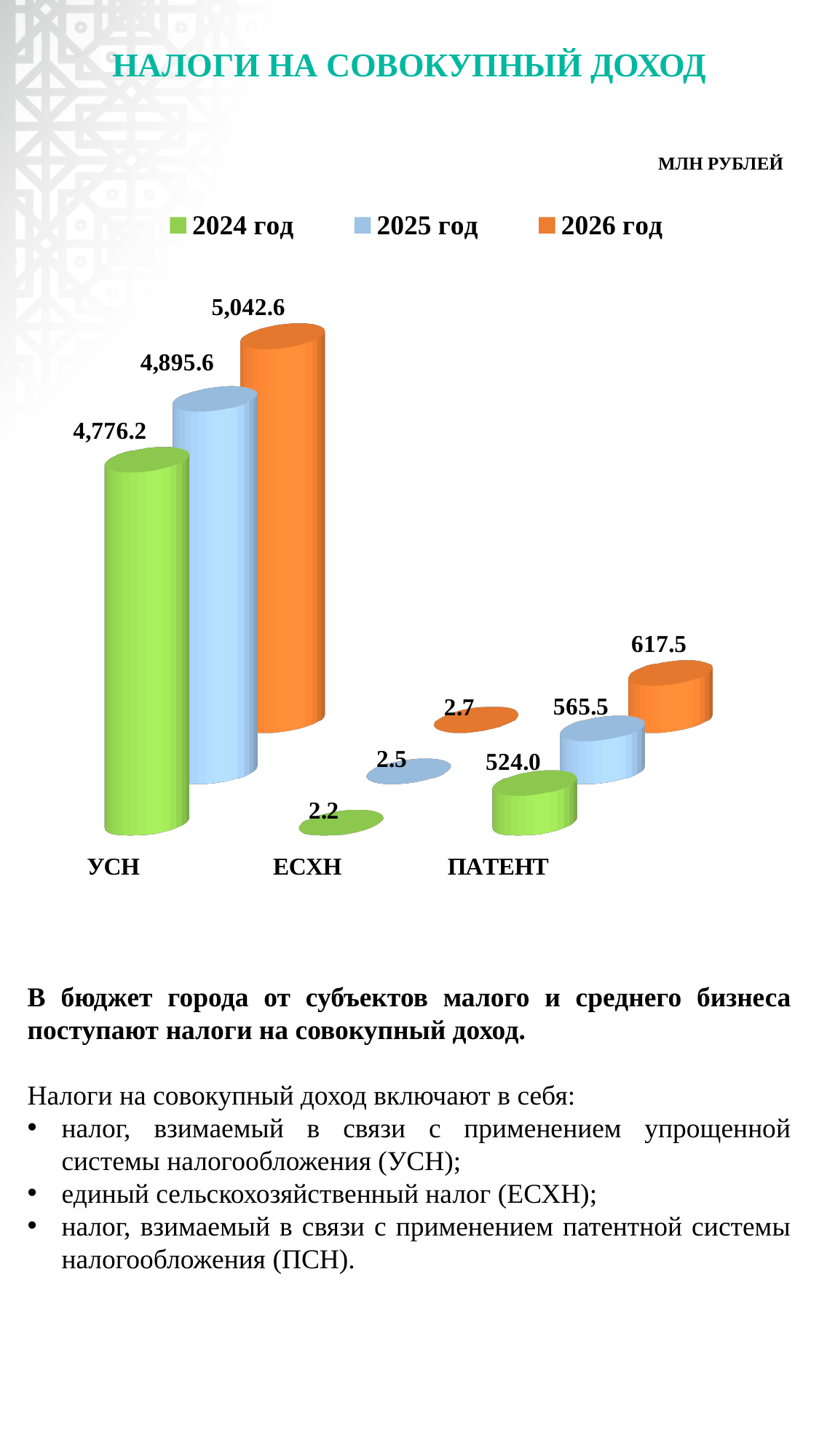
What is the value for УСН in 2024 год? 4,776.2 Do the values for ПАТЕНТ rise or fall from 2024 год to 2026 год? Rise How many series does the legend list? 3 What is the value for ЕСХН in 2025 год? 2.5 Which is larger for ПАТЕНТ: the 2025 год value or the 2026 год value? 2026 год What is the value for ПАТЕНТ in 2026 год? 617.5 Which category has the highest value in 2026 год? УСН What kind of chart is shown on the slide? Bar chart Which category has the lowest value in 2024 год? ЕСХН What is the difference between the 2026 год and 2024 год values for ПАТЕНТ? 93.5 What is the difference between the 2026 год and 2024 год values for УСН? 266.4 How many categories are shown on the x axis? 3